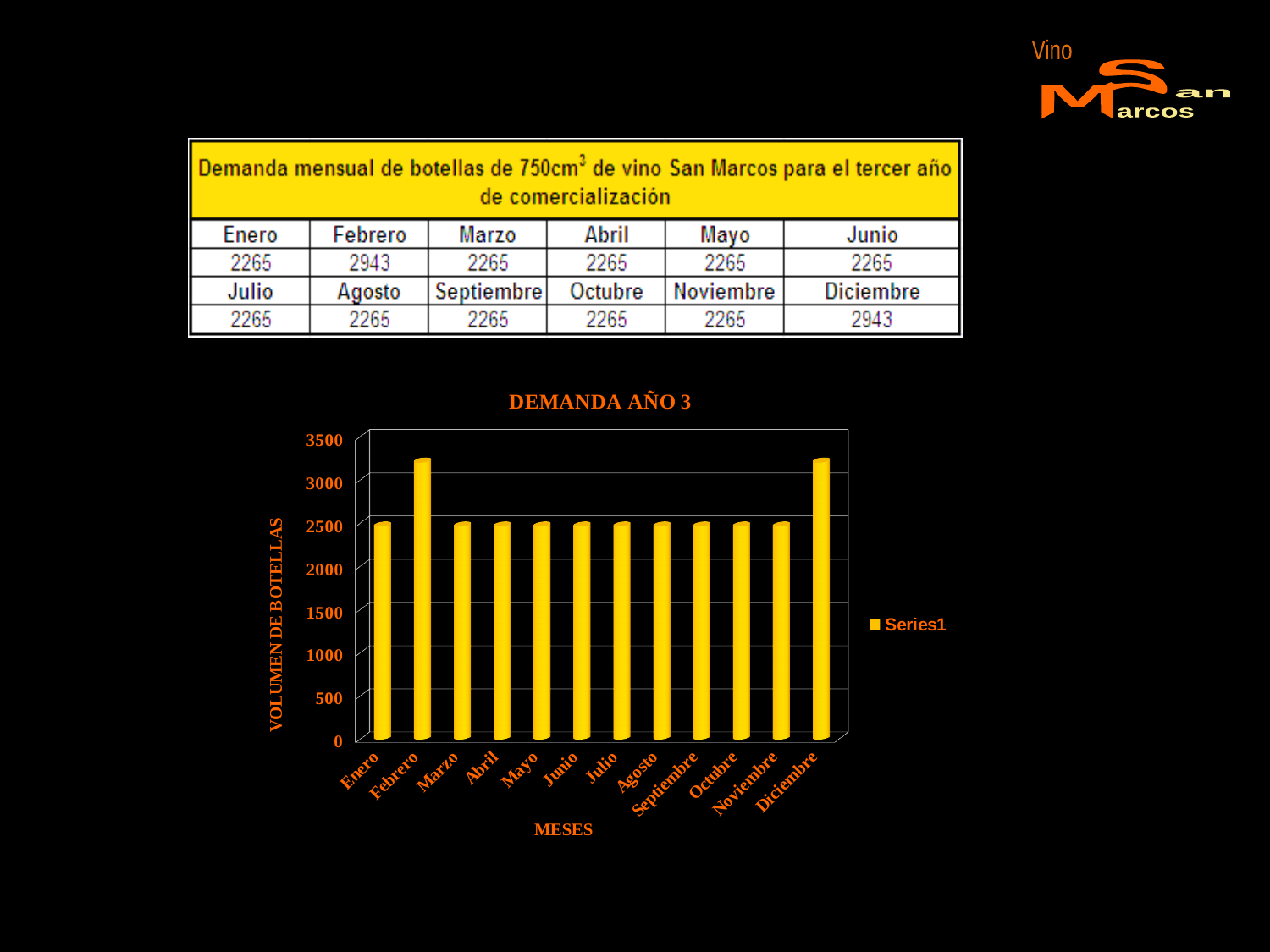
How many months (categories) are plotted on the x axis of the chart? 12 Is the value for Agosto greater or less than 2000? greater Which months have the highest demand in the chart? Febrero and Diciembre According to the table, what is the demand for Febrero? 2943 How many series does the chart legend list? 1 Is the value for Febrero greater or less than 2500? greater Which is larger, the value for Diciembre or the value for Noviembre? Diciembre What kind of chart is shown on the slide? bar chart Using the values in the table, what is the difference between the demand for Febrero and the demand for Enero? 678 What is the label of the vertical axis of the chart? VOLUMEN DE BOTELLAS What is the title of the chart? DEMANDA AÑO 3